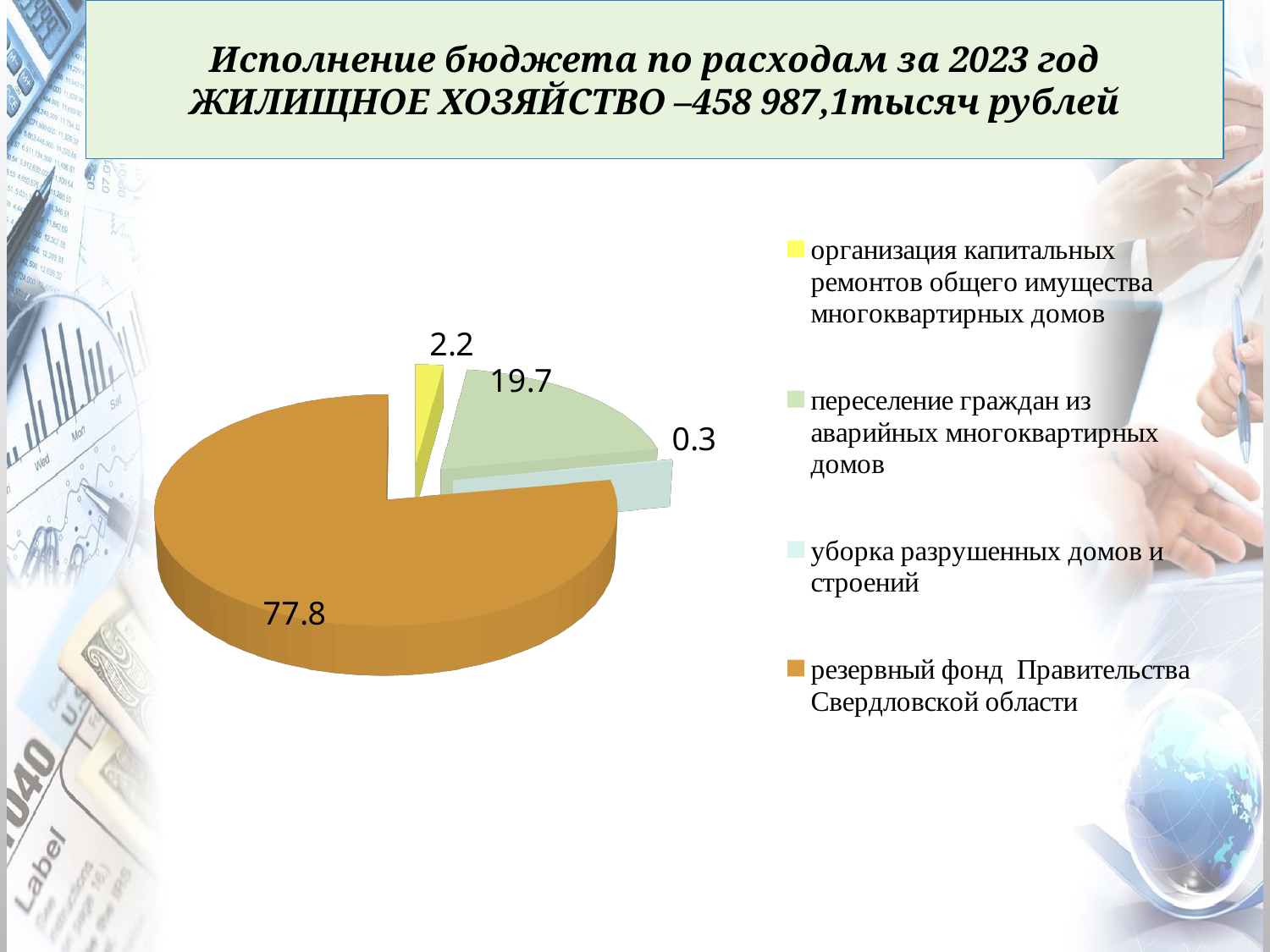
What is the value for организация капитальных ремонтов общего имущества многоквартирных домов? 2.2 What type of chart is shown on the slide? pie chart Which category has the smallest slice of the pie? уборка разрушенных домов и строений What is the difference between the values for резервный фонд Правительства Свердловской области and переселение граждан из аварийных многоквартирных домов? 58.1 What is the value for уборка разрушенных домов и строений? 0.3 Which category has the largest slice of the pie? резервный фонд Правительства Свердловской области How many slices does the pie chart have? 4 What is the value for переселение граждан из аварийных многоквартирных домов? 19.7 Which is larger: the value for организация капитальных ремонтов общего имущества многоквартирных домов or the value for уборка разрушенных домов и строений? организация капитальных ремонтов общего имущества многоквартирных домов How many entries does the legend list? 4 What is the value for резервный фонд Правительства Свердловской области? 77.8 What colour is the slice for резервный фонд Правительства Свердловской области? orange